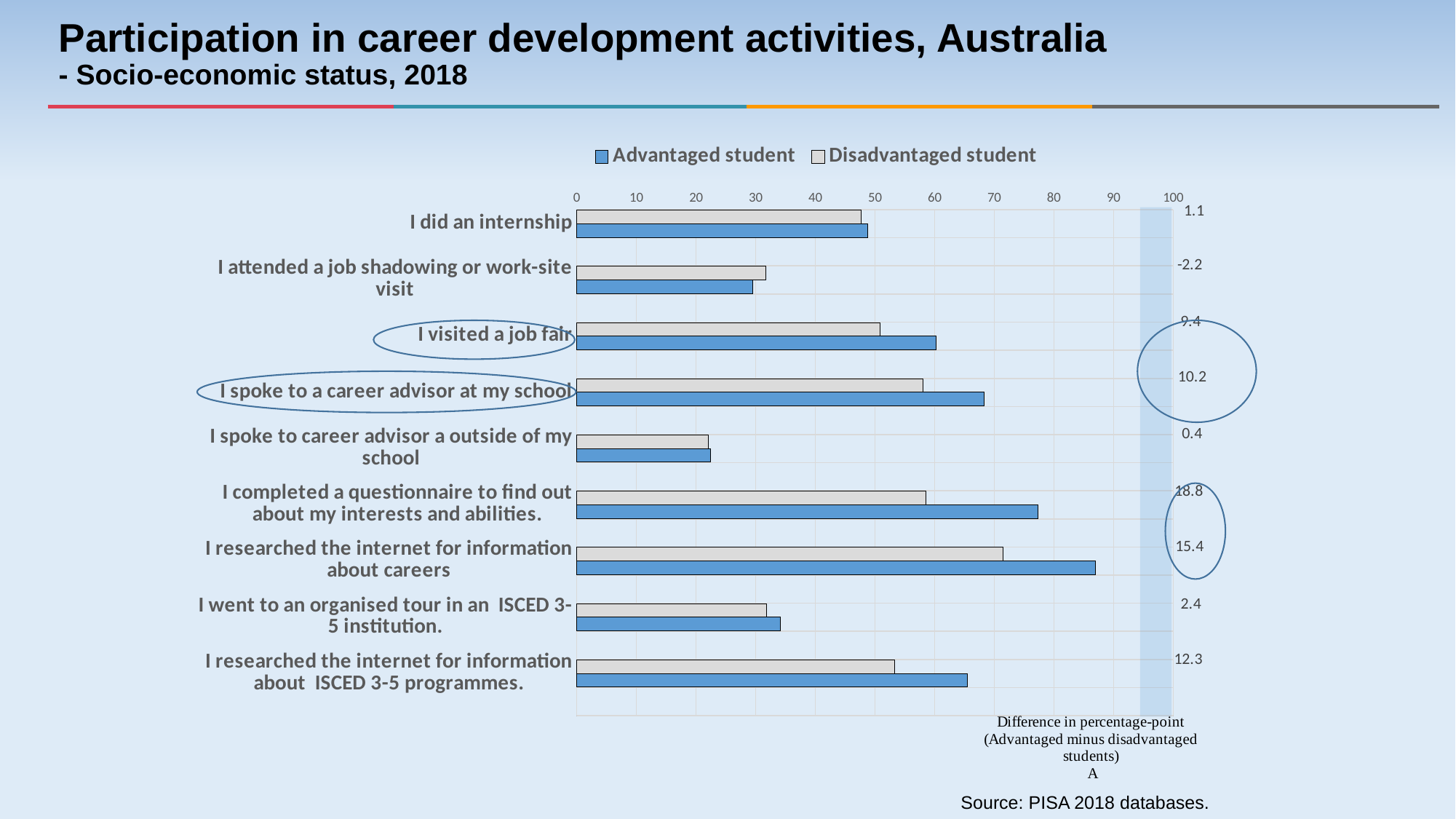
Is the Disadvantaged student value for 'I spoke to career advisor a outside of my school' greater or less than 30? less Is the Advantaged student value for 'I spoke to a career advisor at my school' greater or less than 60? greater Which activity has the highest participation rate for Advantaged students? I researched the internet for information about careers What is the printed difference in percentage-point (Advantaged minus disadvantaged students) for 'I completed a questionnaire to find out about my interests and abilities.'? 18.8 Which colour represents Advantaged students in the chart? blue How many career development activities (categories) are plotted on the chart? 9 How many series does the legend list? 2 What is the printed difference in percentage-point (Advantaged minus disadvantaged students) for 'I attended a job shadowing or work-site visit'? -2.2 Which activity has the lowest participation rate for Disadvantaged students? I spoke to career advisor a outside of my school For 'I completed a questionnaire to find out about my interests and abilities.', which series has the larger value, Advantaged student or Disadvantaged student? Advantaged student What kind of chart is shown on the slide? bar chart Is the Advantaged student value for 'I researched the internet for information about careers' greater or less than 80? greater